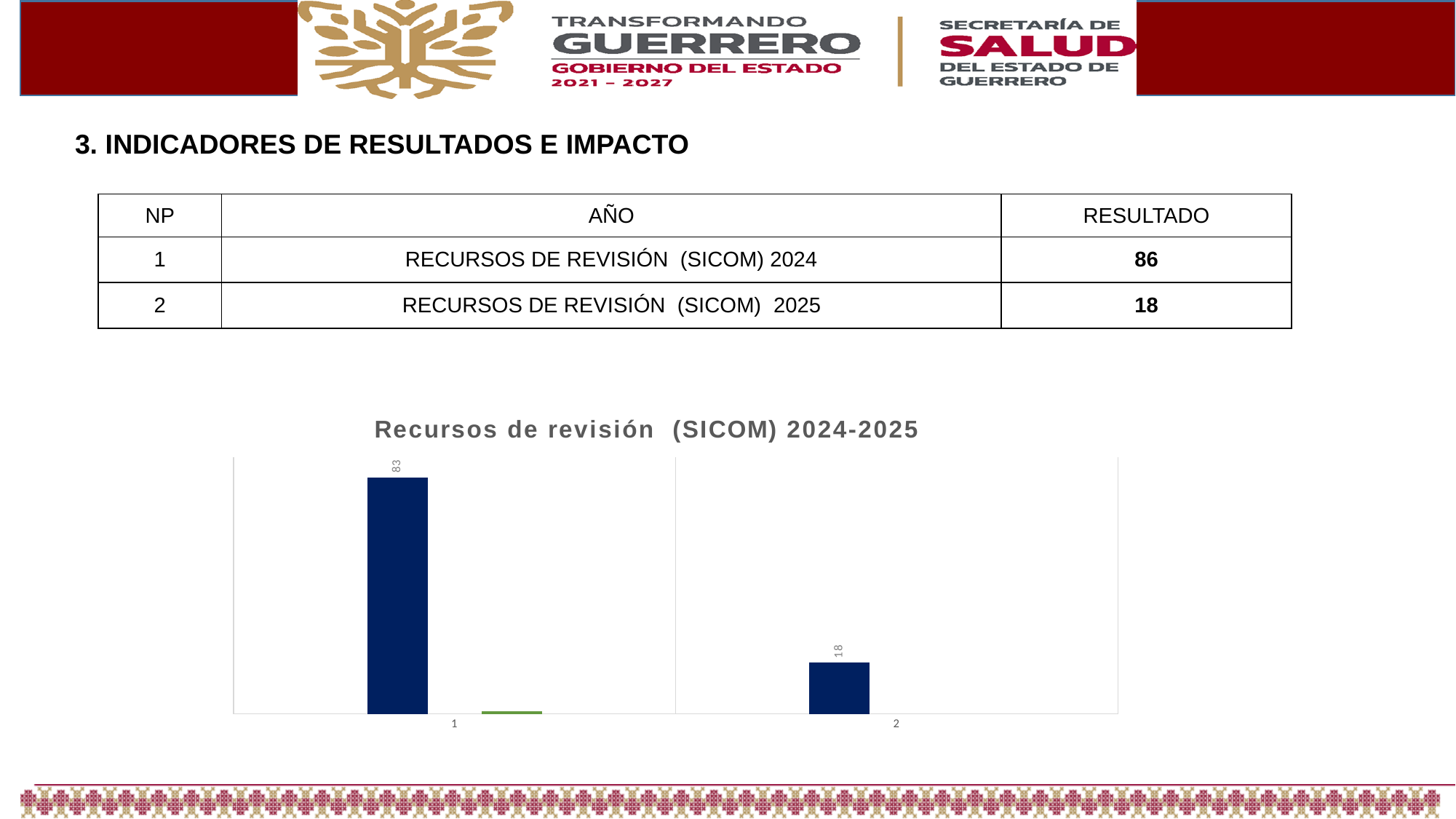
Do the dark blue bar values rise or fall from category 1 to category 2? fall Which dark blue bar is larger, category 1 or category 2? 1 Which category has the tallest bar? 1 What is the data label on the dark blue bar for category 1? 83 What is the title of the chart? Recursos de revisión (SICOM) 2024-2025 What is the data label on the dark blue bar for category 2? 18 What kind of chart is shown on the slide? bar chart What colour is the tallest bar in the chart? dark blue How many categories are shown on the x axis? 2 Which category has the lower dark blue bar? 2 How many bars are plotted for category 1? 2 What is the difference between the dark blue bar values for category 1 and category 2? 65